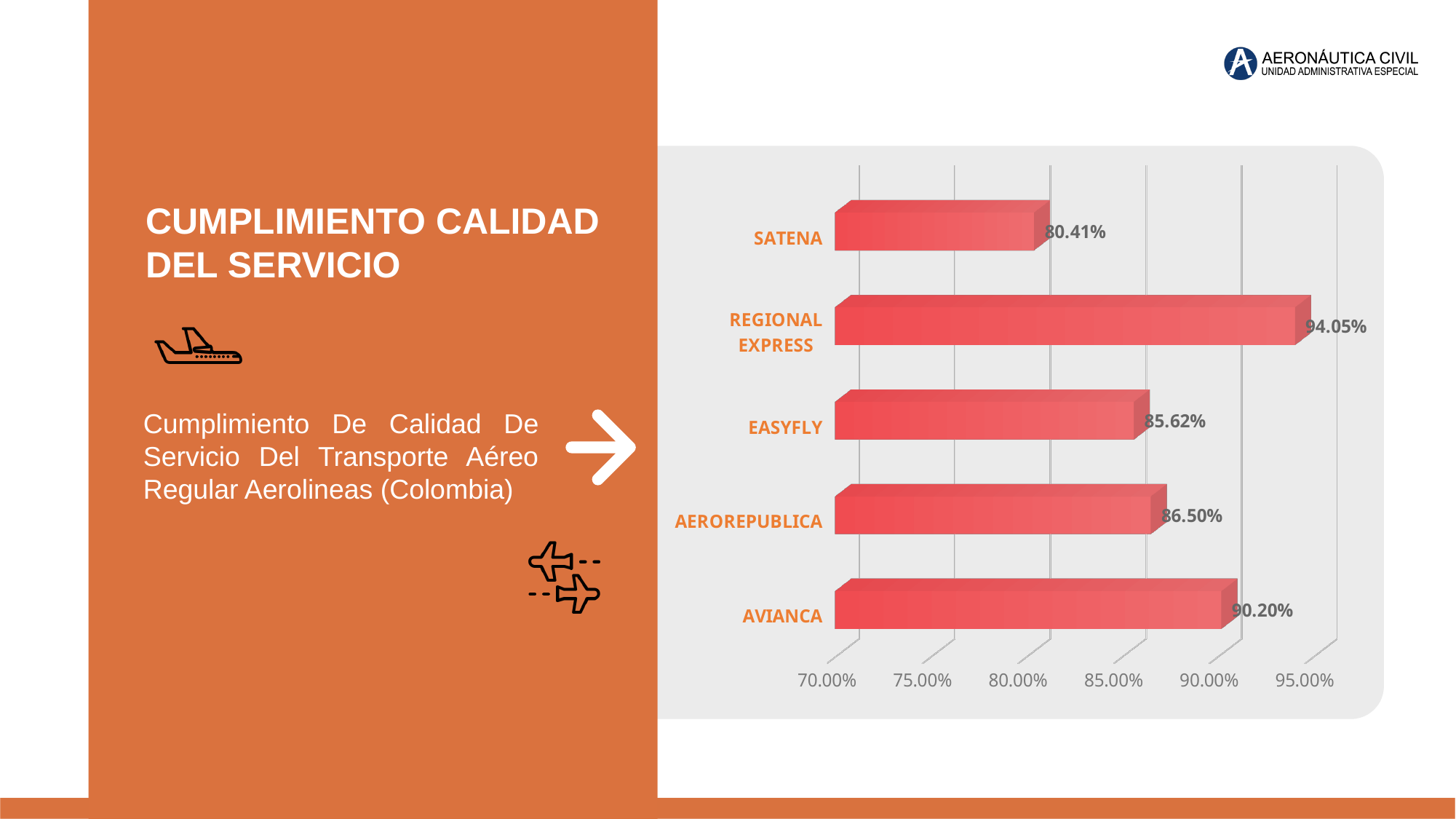
What is the difference between the values for REGIONAL EXPRESS and SATENA? 13.64 percentage points What is the value shown for REGIONAL EXPRESS? 94.05% Which airline has the highest value in the chart? REGIONAL EXPRESS What is the difference between the values for AVIANCA and AEROREPUBLICA? 3.70 percentage points Which has a larger value, AEROREPUBLICA or EASYFLY? AEROREPUBLICA What kind of chart is shown on the slide? Bar chart What is the value shown for AEROREPUBLICA? 86.50% What is the value shown for SATENA? 80.41% Which airline has the lowest value in the chart? SATENA What is the value shown for EASYFLY? 85.62% How many airlines are shown in the chart? 5 What is the value shown for AVIANCA? 90.20%